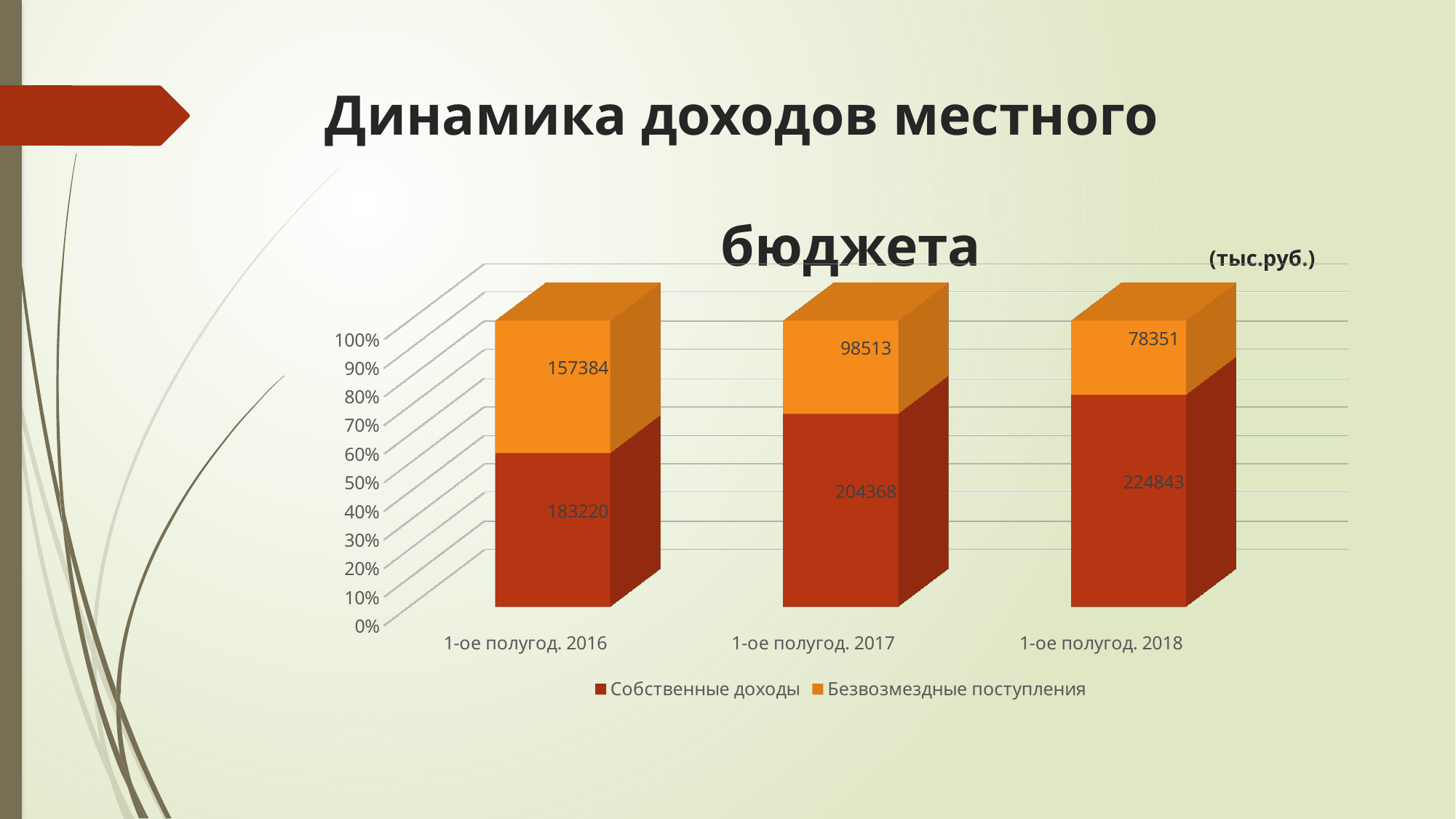
What is the difference between Собственные доходы in 1-ое полугод. 2018 and 1-ое полугод. 2016? 41623 What is the value of Собственные доходы for 1-ое полугод. 2016? 183220 How many series does the legend list? 2 Do the values of Безвозмездные поступления rise or fall from 2016 to 2018? Fall What is the total of the stacked bar for 1-ое полугод. 2016? 340604 In which period is Безвозмездные поступления the lowest? 1-ое полугод. 2018 What is the value of Безвозмездные поступления for 1-ое полугод. 2018? 78351 What kind of chart is shown on the slide? Stacked bar chart What is the value of Безвозмездные поступления for 1-ое полугод. 2017? 98513 Which is larger in 1-ое полугод. 2017: Собственные доходы or Безвозмездные поступления? Собственные доходы In which period is Собственные доходы the highest? 1-ое полугод. 2018 How many periods are shown on the x axis? 3